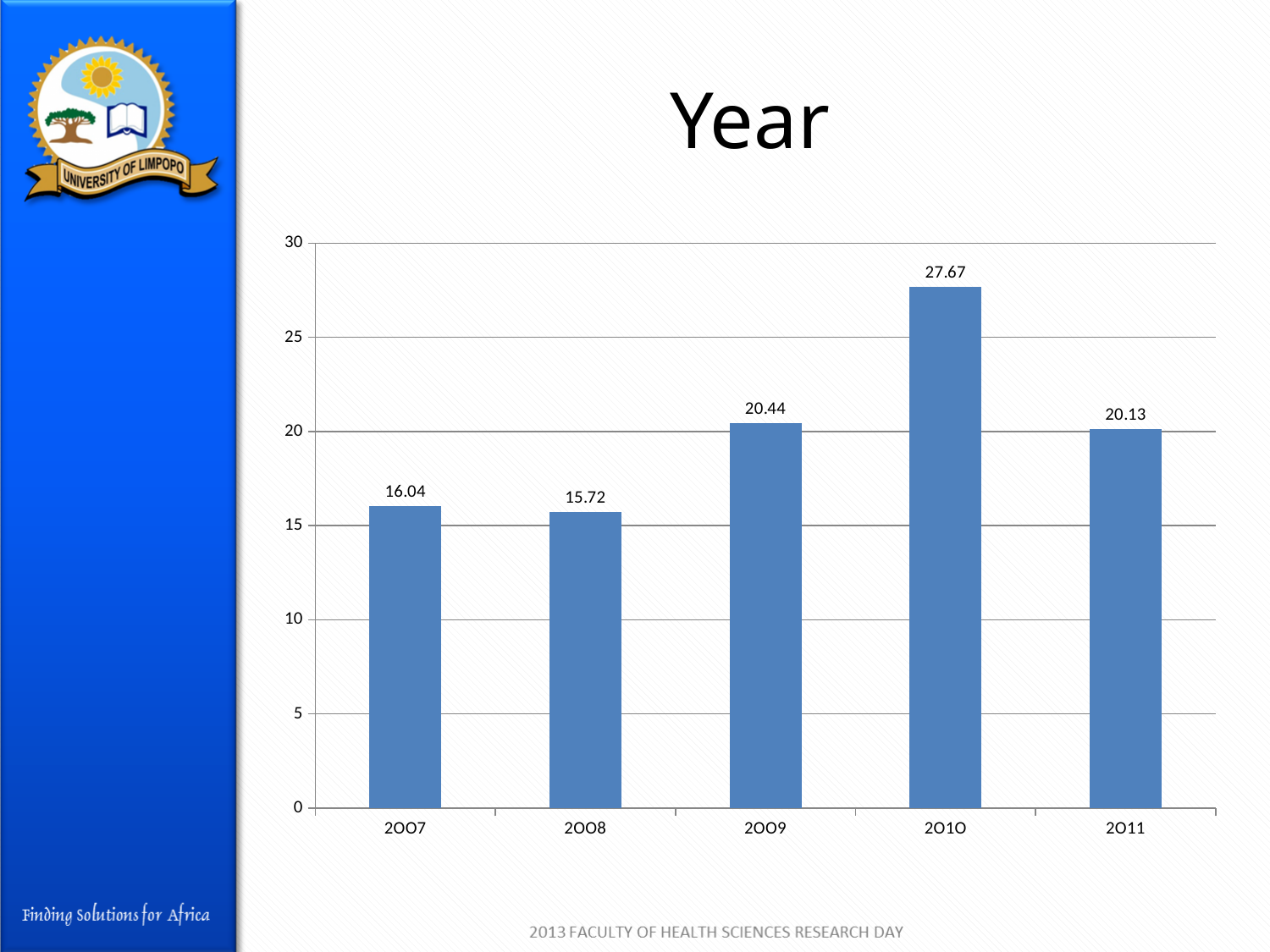
What is the value for 2011? 20.13 What is the difference between the values for 2010 and 2009? 7.23 How many years are shown on the x axis? 5 What is the title of the slide? Year Which year has the lowest value? 2008 Which is larger, the value for 2009 or the value for 2011? 2009 What is the value for 2007? 16.04 What is the value for 2010? 27.67 What kind of chart is shown on the slide? bar chart Is the value for 2010 greater or less than 25? greater Which year has the highest value? 2010 What is the difference between the values for 2007 and 2008? 0.32